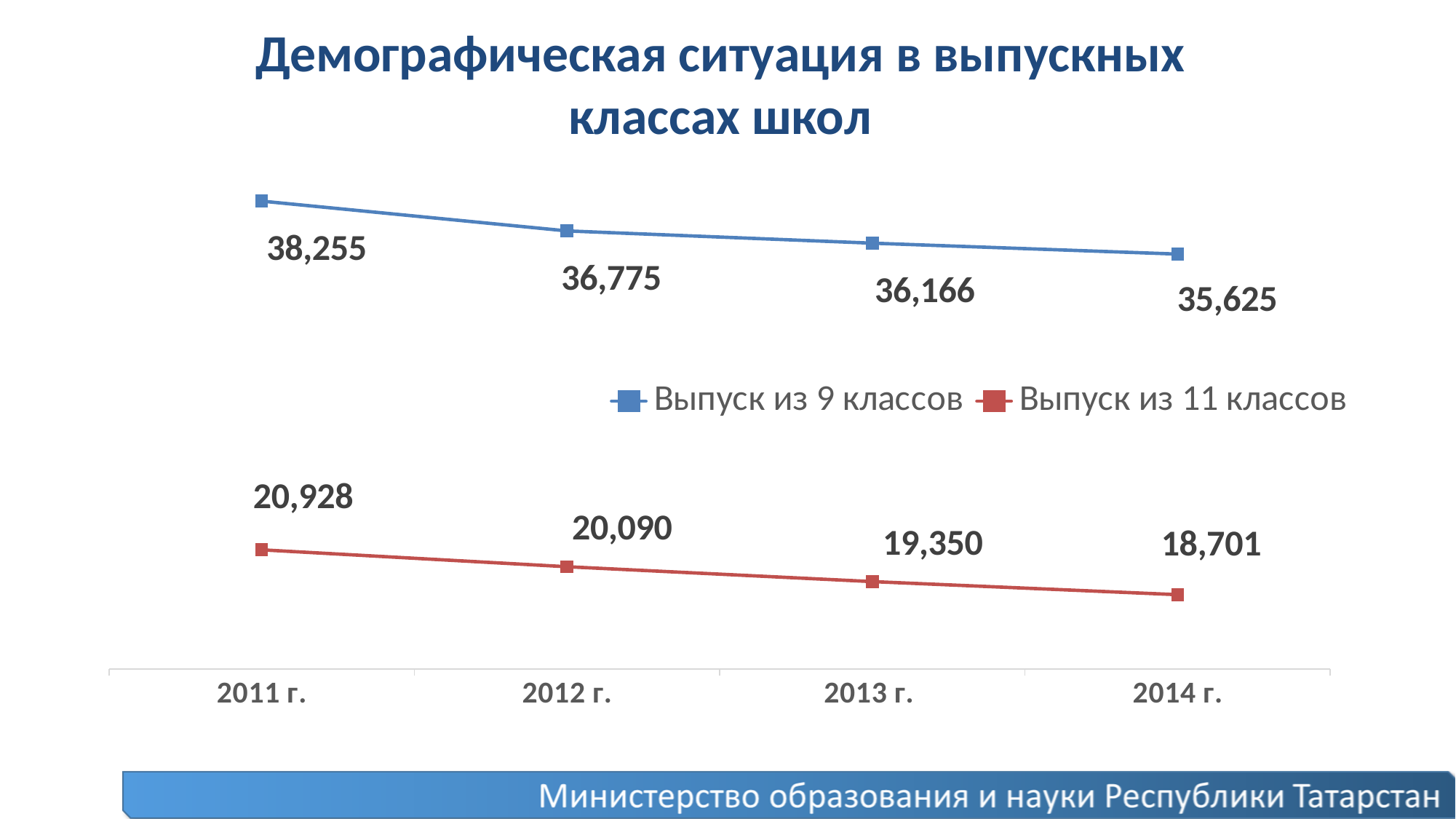
Which is larger in 2012 г.: "Выпуск из 9 классов" or "Выпуск из 11 классов"? Выпуск из 9 классов How many years are shown on the x axis? 4 What is the value for "Выпуск из 11 классов" in 2014 г.? 18,701 What is the value for "Выпуск из 11 классов" in 2012 г.? 20,090 What is the value for "Выпуск из 9 классов" in 2011 г.? 38,255 What is the difference between "Выпуск из 9 классов" and "Выпуск из 11 классов" in 2013 г.? 16,816 In which year is "Выпуск из 11 классов" lowest? 2014 г. In which year is "Выпуск из 9 классов" highest? 2011 г. How many series does the legend list? 2 What is the value for "Выпуск из 9 классов" in 2013 г.? 36,166 What is the difference between "Выпуск из 9 классов" in 2011 г. and 2014 г.? 2,630 What kind of chart is shown on the slide? Line chart